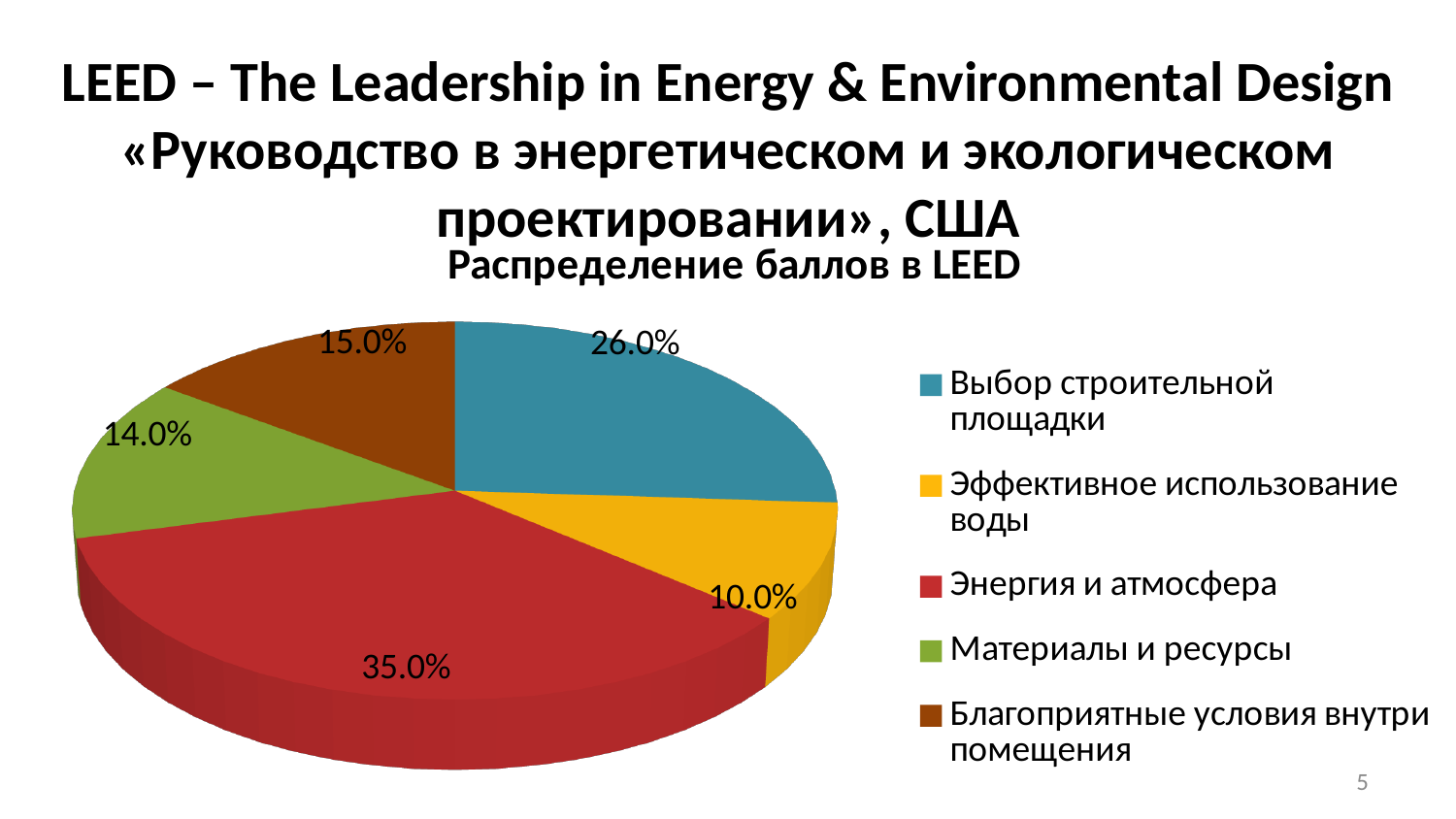
What share of the pie is "Энергия и атмосфера"? 35.0% Which category has the largest share of the pie? Энергия и атмосфера What is the value for "Выбор строительной площадки"? 26.0% How many slices does the pie chart have? 5 What is the value for "Благоприятные условия внутри помещения"? 15.0% Which is larger: "Материалы и ресурсы" or "Благоприятные условия внутри помещения"? Благоприятные условия внутри помещения What is the value for "Эффективное использование воды"? 10.0% What type of chart is shown on the slide? Pie chart What is the title of the chart? Распределение баллов в LEED Which category has the smallest share of the pie? Эффективное использование воды What is the value for "Материалы и ресурсы"? 14.0% What is the difference between the shares of "Энергия и атмосфера" and "Выбор строительной площадки"? 9.0%